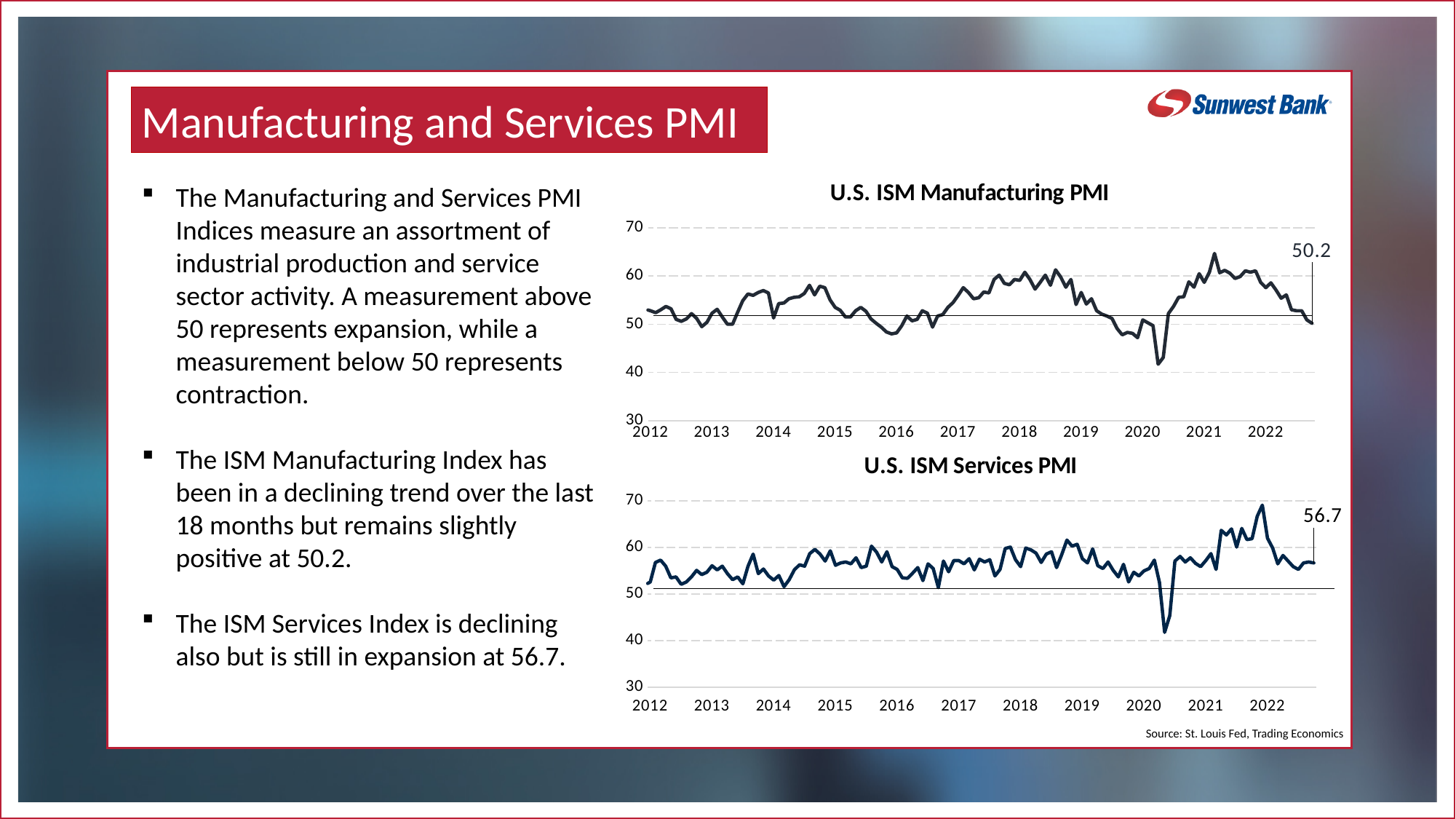
On the U.S. ISM Services PMI chart, is the peak value in 2021 greater or less than 60? greater What kind of chart is the U.S. ISM Manufacturing PMI chart? Line chart On the U.S. ISM Manufacturing PMI chart, is the lowest value in 2020 greater or less than 50? less What source is cited beneath the charts? St. Louis Fed, Trading Economics What is the difference between the latest labelled value on the U.S. ISM Services PMI chart (56.7) and the latest labelled value on the U.S. ISM Manufacturing PMI chart (50.2)? 6.5 On the U.S. ISM Manufacturing PMI chart, what is the latest value labelled at the end of the line? 50.2 On the U.S. ISM Services PMI chart, what is the latest value labelled at the end of the line? 56.7 On the U.S. ISM Services PMI chart, is the lowest value in 2020 greater or less than 50? less How many year labels are shown on the x axis of the U.S. ISM Services PMI chart? 11 Which is larger, the latest labelled value on the U.S. ISM Manufacturing PMI chart or the latest labelled value on the U.S. ISM Services PMI chart? U.S. ISM Services PMI On the U.S. ISM Manufacturing PMI chart, does the line rise or fall over the course of 2022? Fall